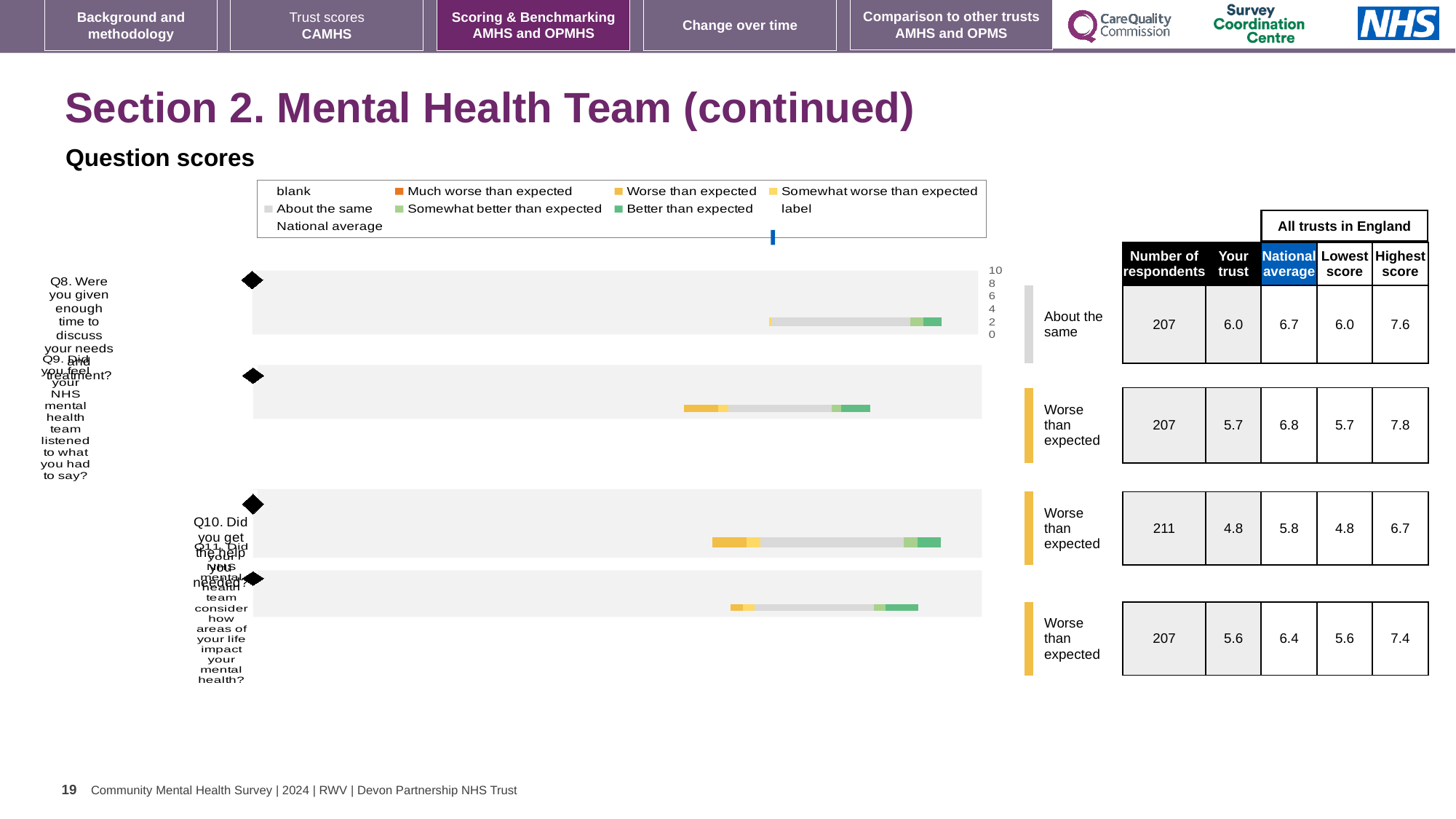
What is the highest score across all trusts in England for Q11? 7.4 What is the 'Your trust' score for Q8 in the table beside the chart? 6.0 What is the difference between the national average and the 'Your trust' score for Q10? 1.0 What is the national average score for Q9 in the table beside the chart? 6.8 Which question in the chart is rated 'About the same' in the benchmark column? Q8 What kind of chart is used to show the question scores on this slide? bar chart What benchmark label is shown for Q11 next to the chart? Worse than expected Which question has the lowest 'Your trust' score in the table beside the chart? Q10 Is the 'Your trust' score for Q9 larger or smaller than the 'Your trust' score for Q11? larger What is the number of respondents for Q10 in the table beside the chart? 211 Which question has the highest national average score in the table beside the chart? Q9 How many questions (categories) are plotted in the question scores chart? 4